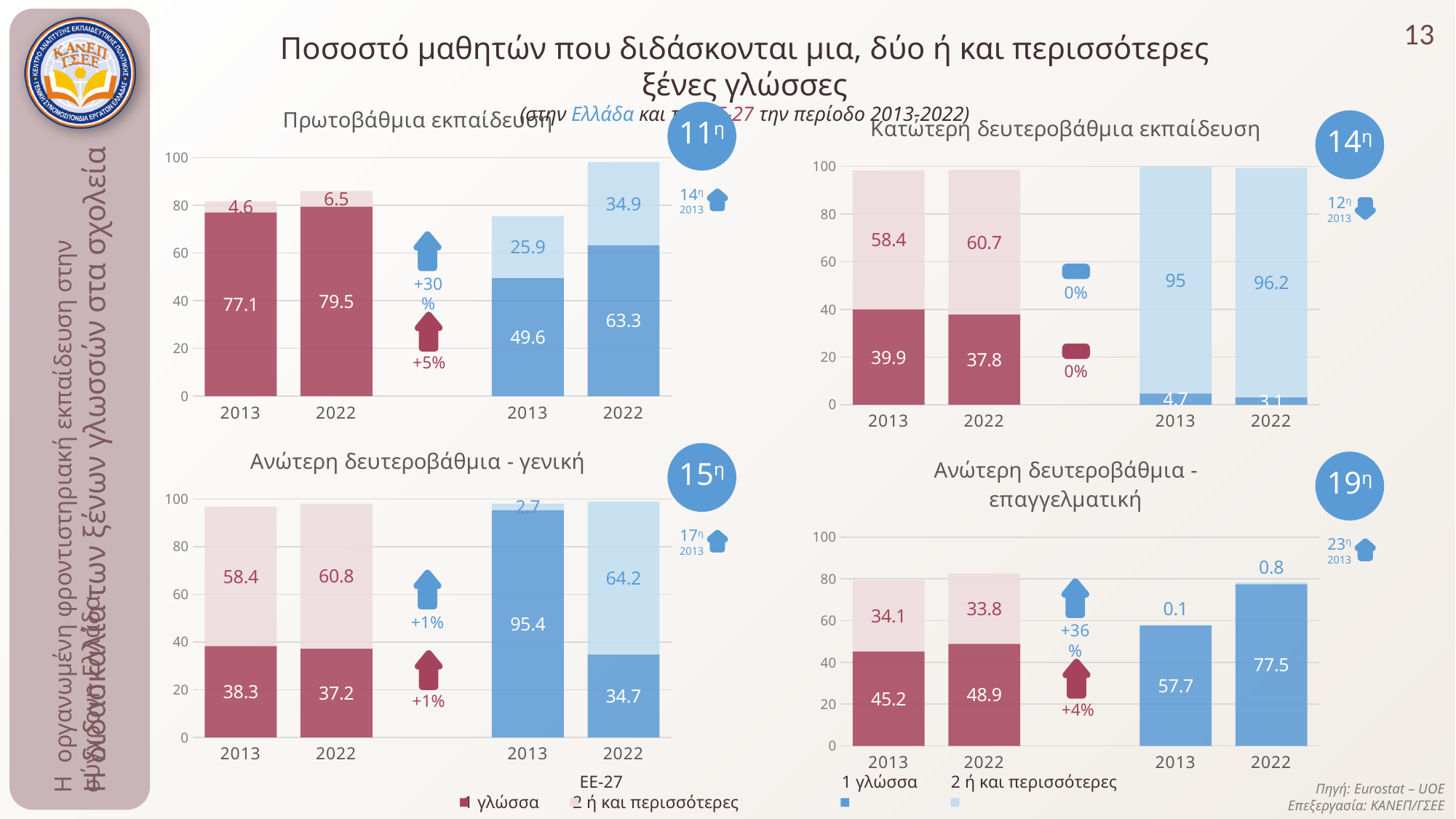
In the 'Κατώτερη δευτεροβάθμια εκπαίδευση' chart, which is larger: the 1 γλώσσα value for Greece in 2013 or for EU-27 in 2013? Greece in 2013 In the 'Πρωτοβάθμια εκπαίδευση' chart, what is the value for 2 ή και περισσότερες in EU-27 in 2022? 34.9 In the 'Κατώτερη δευτεροβάθμια εκπαίδευση' chart, what is the total of the stacked bar for Greece in 2013? 98.3 In the 'Πρωτοβάθμια εκπαίδευση' chart, what is the difference between the EU-27 1 γλώσσα values for 2022 and 2013? 13.7 In the 'Πρωτοβάθμια εκπαίδευση' chart, what is the value for 1 γλώσσα in Greece in 2013? 77.1 In the 'Κατώτερη δευτεροβάθμια εκπαίδευση' chart, what is the value for 2 ή και περισσότερες in EU-27 in 2022? 96.2 In the 'Ανώτερη δευτεροβάθμια - γενική' chart, what is the value for 1 γλώσσα in EU-27 in 2013? 95.4 In the 'Ανώτερη δευτεροβάθμια - επαγγελματική' chart, which bar has the highest 1 γλώσσα value? EU-27 2022 In the 'Πρωτοβάθμια εκπαίδευση' chart, what is the total of the stacked bar for Greece in 2013? 81.7 In the 'Ανώτερη δευτεροβάθμια - γενική' chart, what is the total of the stacked bar for EU-27 in 2022? 98.9 What kind of chart is the 'Ανώτερη δευτεροβάθμια - επαγγελματική' chart? Stacked bar chart In the 'Ανώτερη δευτεροβάθμια - επαγγελματική' chart, what is the difference between the Greece 1 γλώσσα values for 2022 and 2013? 3.7